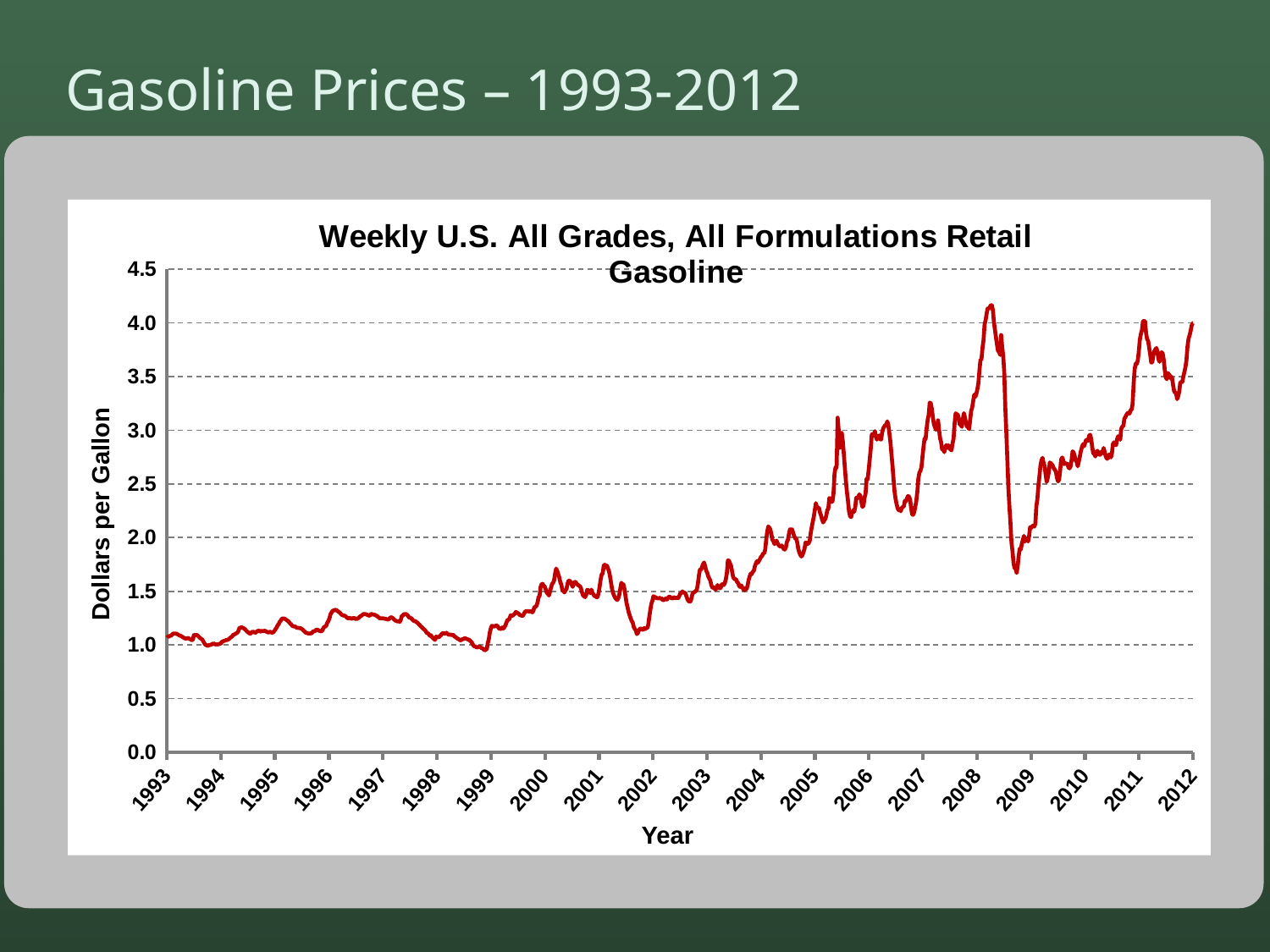
In which year does the line reach its highest point? 2008 Is the value at the start of 1993 greater or less than 1.5 dollars per gallon? less Overall, do gasoline prices rise or fall from 1993 to 2012? rise Is the peak value reached in 2008 greater or less than 4.0 dollars per gallon? greater How many year labels are shown along the x axis? 20 Is the value at the start of 2007 greater or less than 2.5 dollars per gallon? less What is the title of the chart? Weekly U.S. All Grades, All Formulations Retail Gasoline What is the label on the vertical axis of the chart? Dollars per Gallon What kind of chart is shown on the slide? line chart Which is higher, the price at the start of 1995 or the price at the start of 2010? 2010